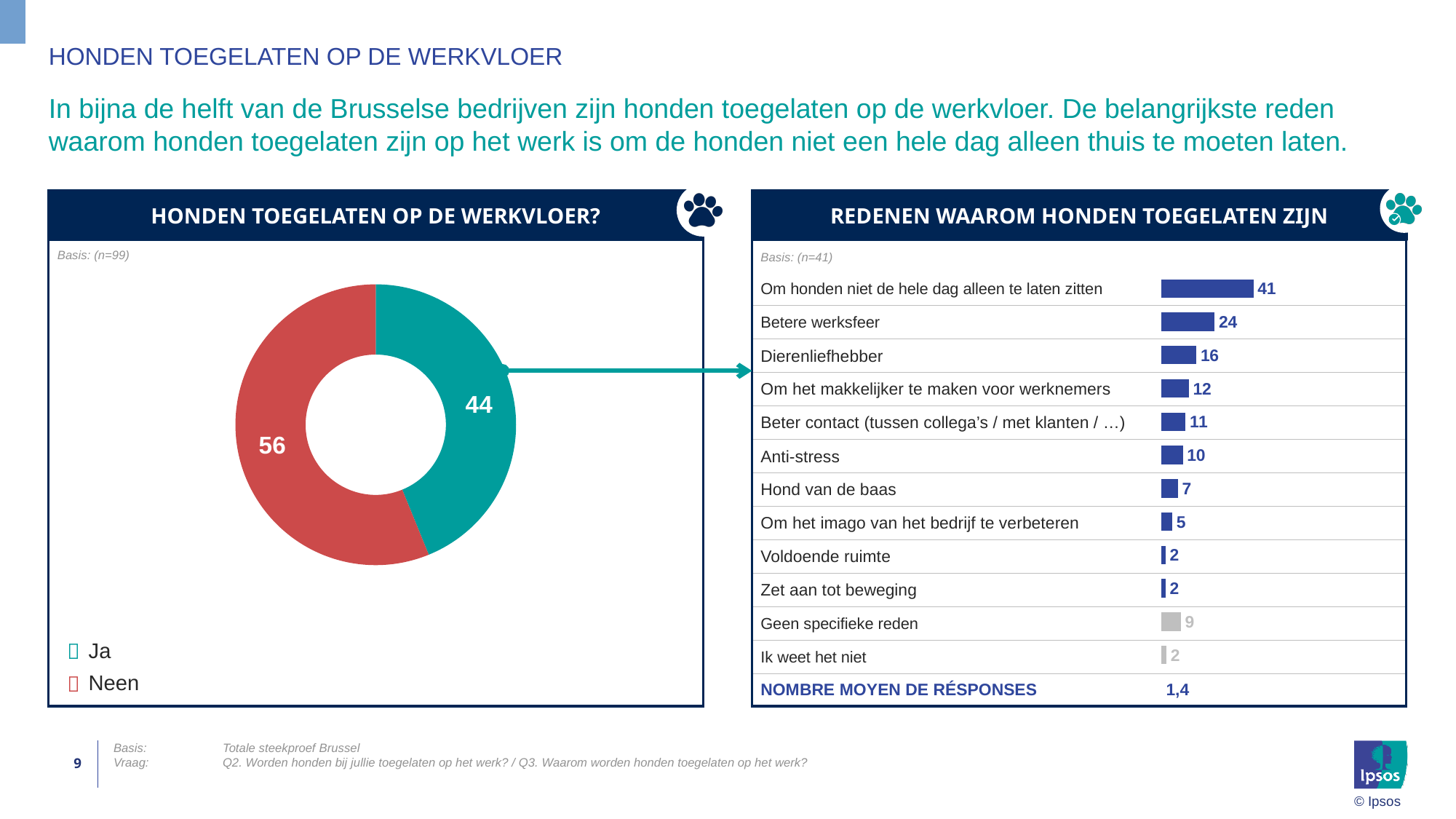
What kind of chart is 'REDENEN WAAROM HONDEN TOEGELATEN ZIJN'? Bar chart In the chart 'HONDEN TOEGELATEN OP DE WERKVLOER?', what is the value for 'Ja'? 44 In the chart 'REDENEN WAAROM HONDEN TOEGELATEN ZIJN', what is the value for 'Geen specifieke reden'? 9 In the chart 'REDENEN WAAROM HONDEN TOEGELATEN ZIJN', what is the value for 'Anti-stress'? 10 In the chart 'REDENEN WAAROM HONDEN TOEGELATEN ZIJN', what is the value for 'Betere werksfeer'? 24 In the chart 'HONDEN TOEGELATEN OP DE WERKVLOER?', what is the value for 'Neen'? 56 In the chart 'REDENEN WAAROM HONDEN TOEGELATEN ZIJN', which is larger, 'Dierenliefhebber' or 'Hond van de baas'? Dierenliefhebber In the chart 'REDENEN WAAROM HONDEN TOEGELATEN ZIJN', which reason has the highest value? Om honden niet de hele dag alleen te laten zitten In the chart 'HONDEN TOEGELATEN OP DE WERKVLOER?', which category is larger, 'Ja' or 'Neen'? Neen In the chart 'HONDEN TOEGELATEN OP DE WERKVLOER?', what is the difference between 'Neen' and 'Ja'? 12 What kind of chart is 'HONDEN TOEGELATEN OP DE WERKVLOER?'? Pie chart (donut) In the chart 'REDENEN WAAROM HONDEN TOEGELATEN ZIJN', what is the difference between 'Om honden niet de hele dag alleen te laten zitten' and 'Betere werksfeer'? 17